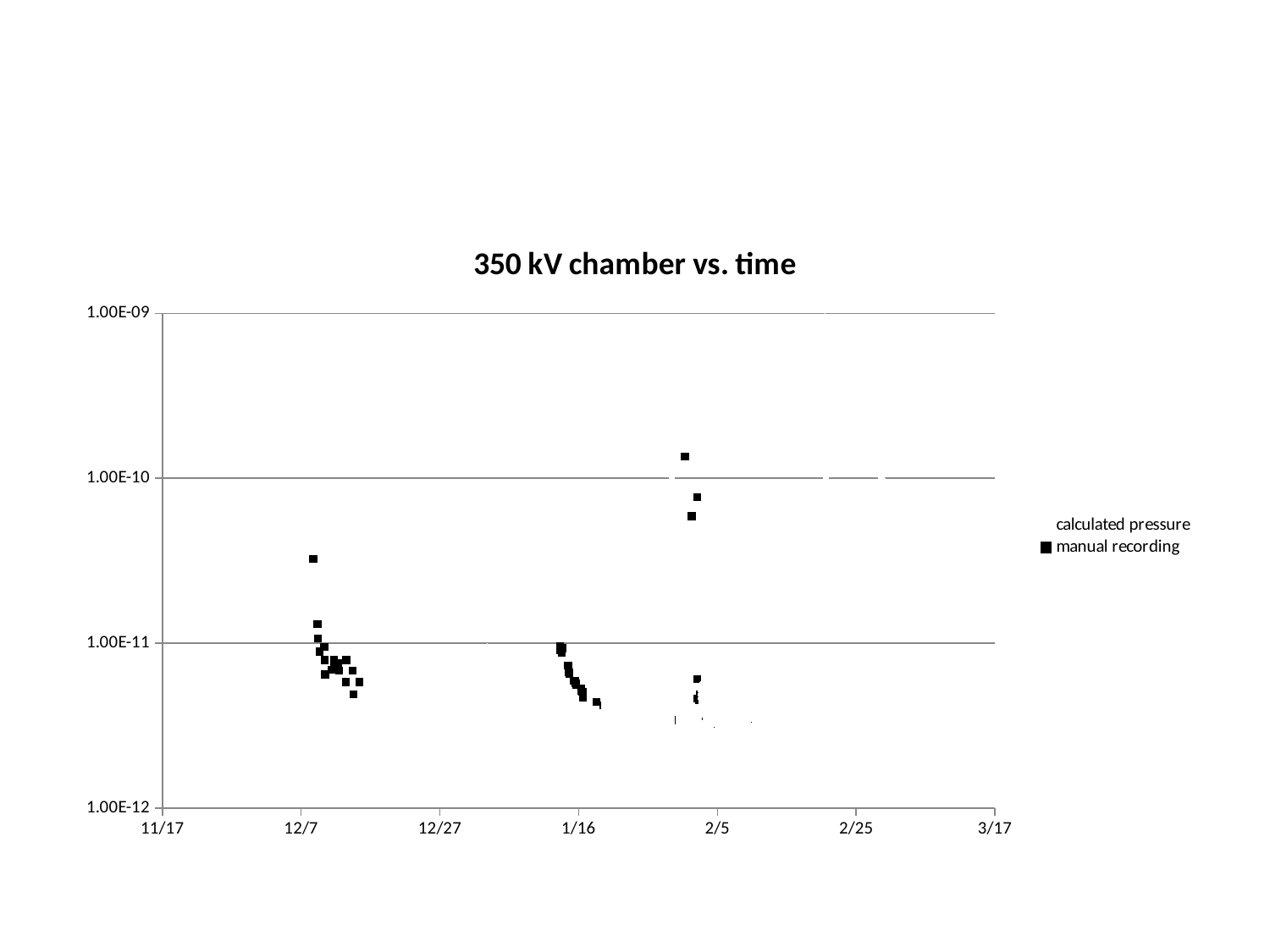
Is the highest manual recording point near 12/7 greater or less than 1.00E-11? greater How many series does the legend list? 2 What kind of chart is shown on the slide? scatter chart Are the lowest manual recording points near 2/5 greater or less than 1.00E-11? less What is the lowest value labelled on the y axis? 1.00E-12 Is the highest manual recording point near 2/5 greater or less than 1.00E-10? greater What is the title of the chart? 350 kV chamber vs. time How many date labels are shown on the x axis? 7 What is the highest value labelled on the y axis? 1.00E-09 What are the two series named in the legend? calculated pressure, manual recording